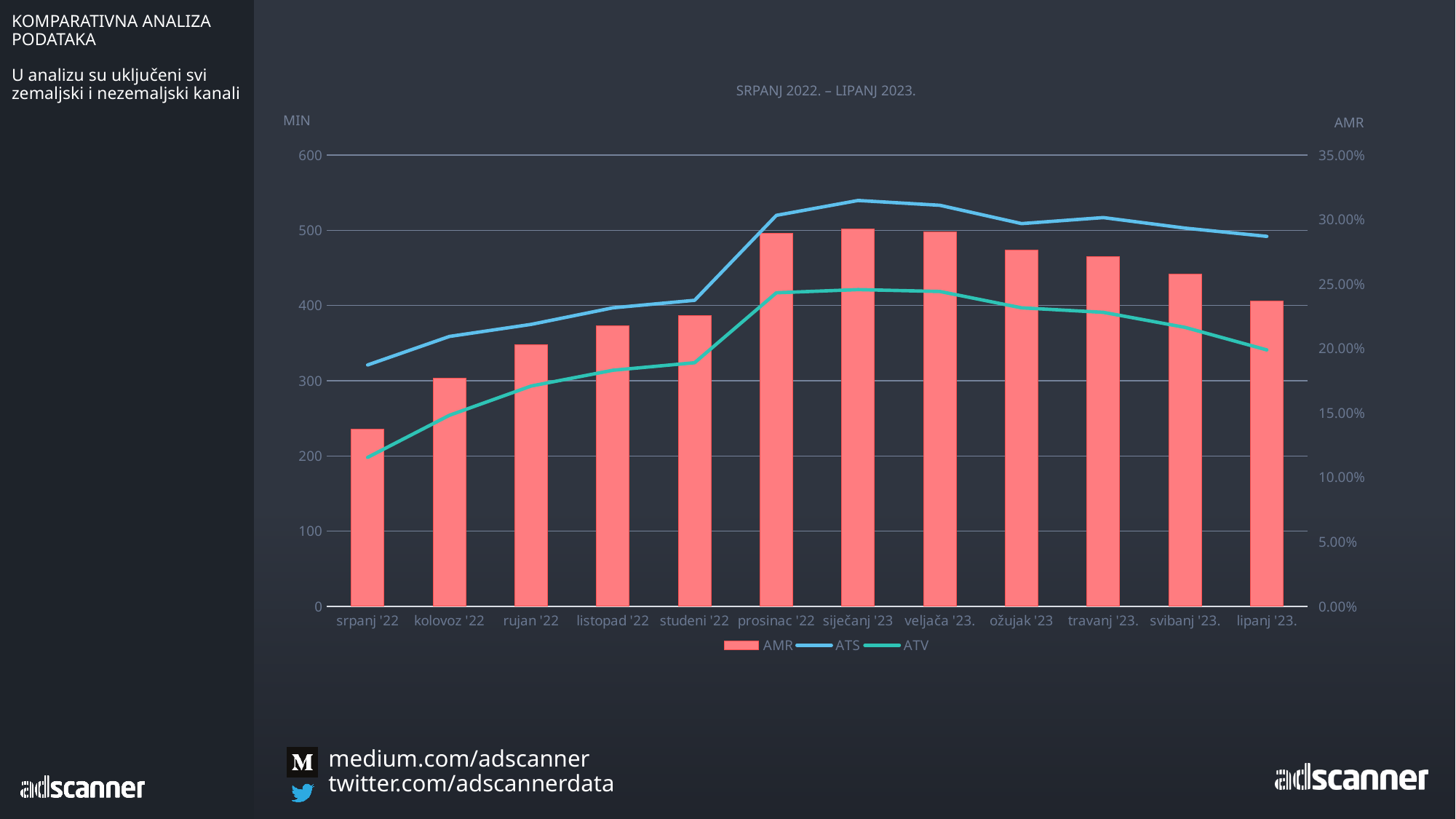
Does the ATV line rise or fall from veljača '23 to lipanj '23? fall Which is larger, the AMR bar for kolovoz '22 or the AMR bar for svibanj '23? svibanj '23 What kind of chart is shown on the slide? Combined bar and line chart Which month has the lowest AMR bar? srpanj '22 Read against the right-hand axis, is the AMR bar for srpanj '22 greater or less than 15.00%? less What is the title of the chart? SRPANJ 2022. – LIPANJ 2023. How many series does the chart legend list? 3 In which month does the ATS line reach its highest point? siječanj '23 How many months (categories) are shown on the x axis? 12 Do the AMR bars rise or fall from srpanj '22 to siječanj '23? rise Which is larger, the AMR bar for srpanj '22 or the AMR bar for lipanj '23? lipanj '23 Which series is drawn as bars? AMR